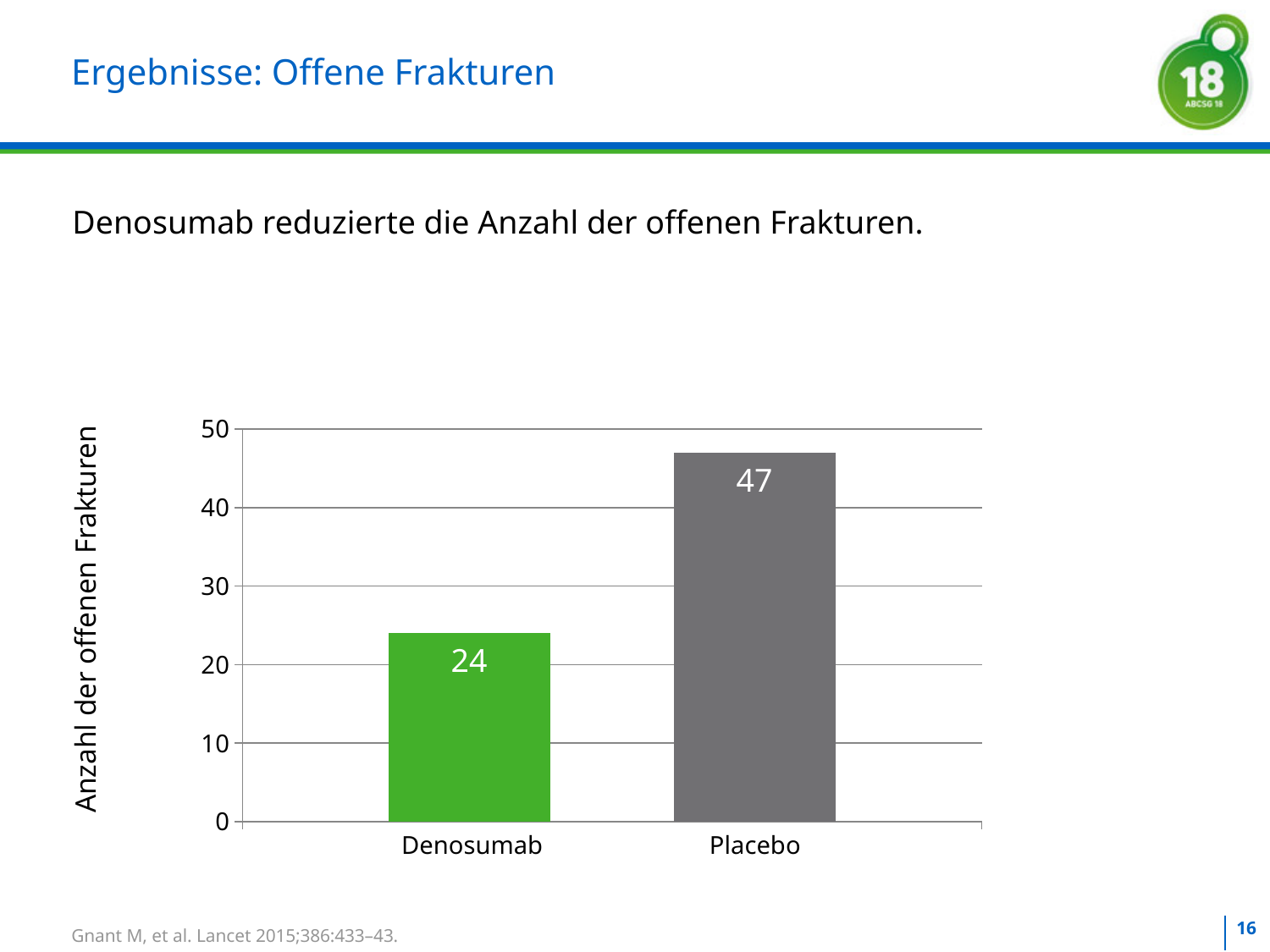
Which group has the higher number of open fractures? Placebo How many categories are shown on the x axis? 2 What is the number of open fractures for Denosumab? 24 Which group has the lower number of open fractures? Denosumab Is the value for Denosumab greater or less than 30? less What is the difference in the number of open fractures between Placebo and Denosumab? 23 What is the number of open fractures for Placebo? 47 What kind of chart is shown on the slide? bar chart What colour is the Denosumab bar? green What is the maximum value shown on the y axis? 50 What is the label of the y axis? Anzahl der offenen Frakturen Is the value for Placebo greater or less than 40? greater